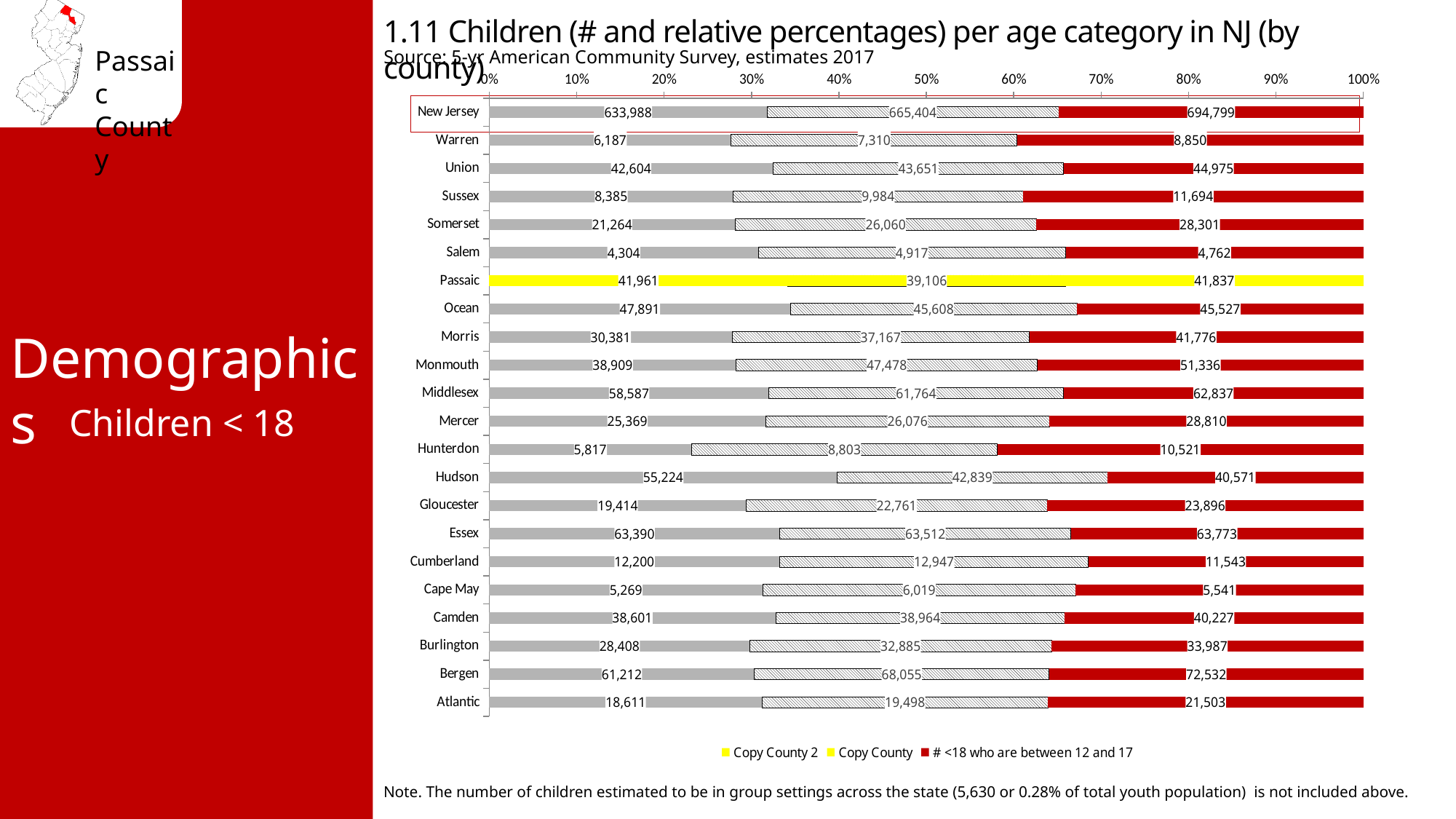
What is the value labelled on the middle segment of the Atlantic bar? 19,498 Which county's bar is highlighted in yellow? Passaic Which category has the lowest value for '# <18 who are between 12 and 17'? Salem What is the difference between the leftmost segment value (41,961) and the middle segment value (39,106) for Passaic? 2,855 Which has a larger value for '# <18 who are between 12 and 17', Hudson or Bergen? Bergen What is the value of '# <18 who are between 12 and 17' for New Jersey? 694,799 What is the total of the three labelled values for Passaic? 122,904 How many series does the legend list? 3 What is the value labelled on the leftmost segment of the Hudson bar? 55,224 What is the value of '# <18 who are between 12 and 17' for Passaic? 41,837 What type of chart is shown on the slide? bar chart How many categories (rows) are plotted on the chart? 22